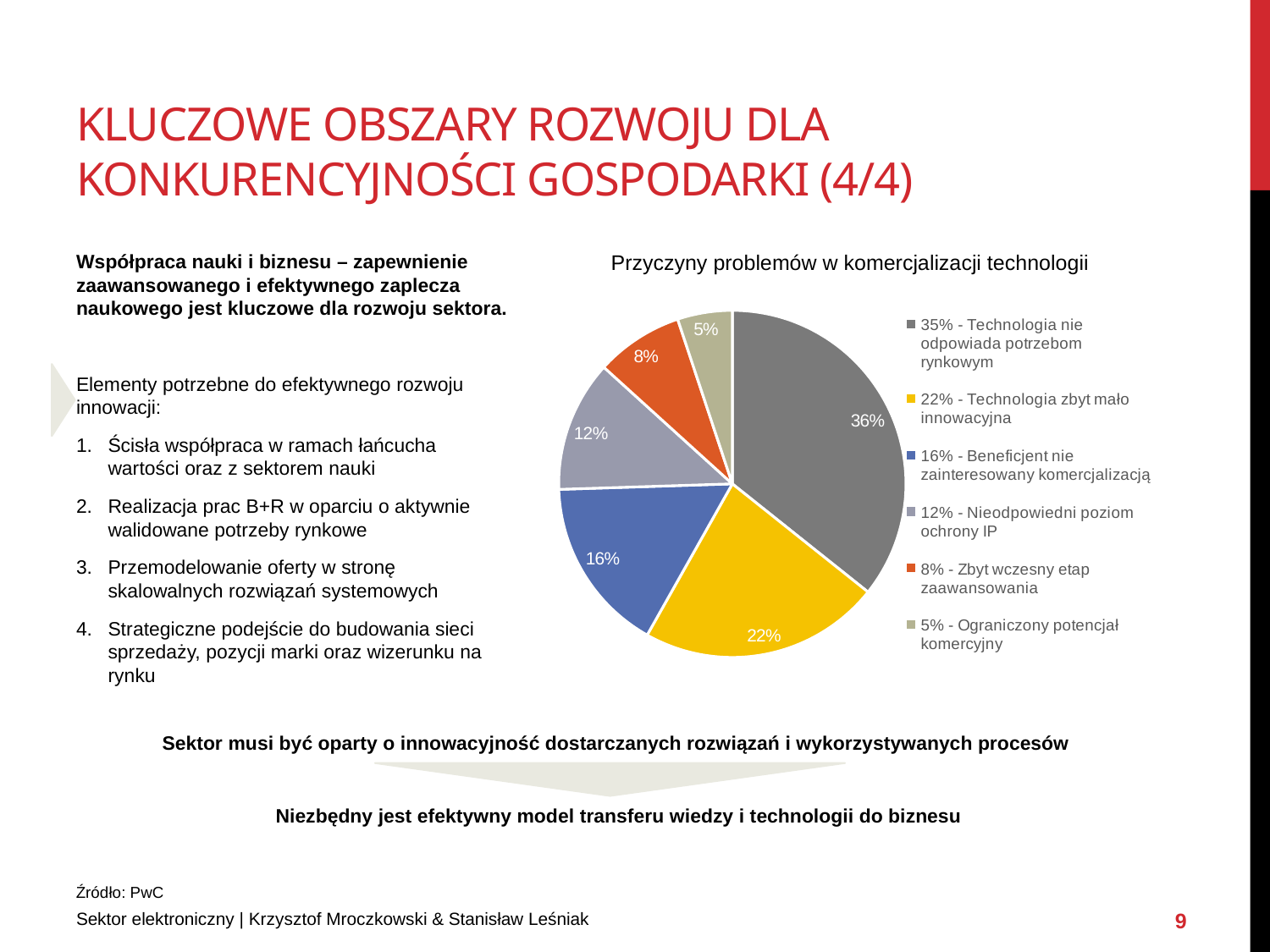
Which slice is larger: 'Nieodpowiedni poziom ochrony IP' or 'Zbyt wczesny etap zaawansowania'? Nieodpowiedni poziom ochrony IP By how many percentage points does 'Technologia zbyt mało innowacyjna' exceed 'Beneficjent nie zainteresowany komercjalizacją'? 6 percentage points How many entries does the chart legend list? 6 How many slices does the pie chart have? 6 What kind of chart is shown on the slide? Pie chart What share of the pie is labelled for 'Technologia zbyt mało innowacyjna'? 22% What share of the pie is labelled for 'Beneficjent nie zainteresowany komercjalizacją'? 16% Which category has the largest slice of the pie? Technologia nie odpowiada potrzebom rynkowym What share of the pie is labelled for 'Zbyt wczesny etap zaawansowania'? 8% What share of the pie is labelled for 'Nieodpowiedni poziom ochrony IP'? 12% What is the title of the chart? Przyczyny problemów w komercjalizacji technologii Which category has the smallest slice of the pie? Ograniczony potencjał komercyjny